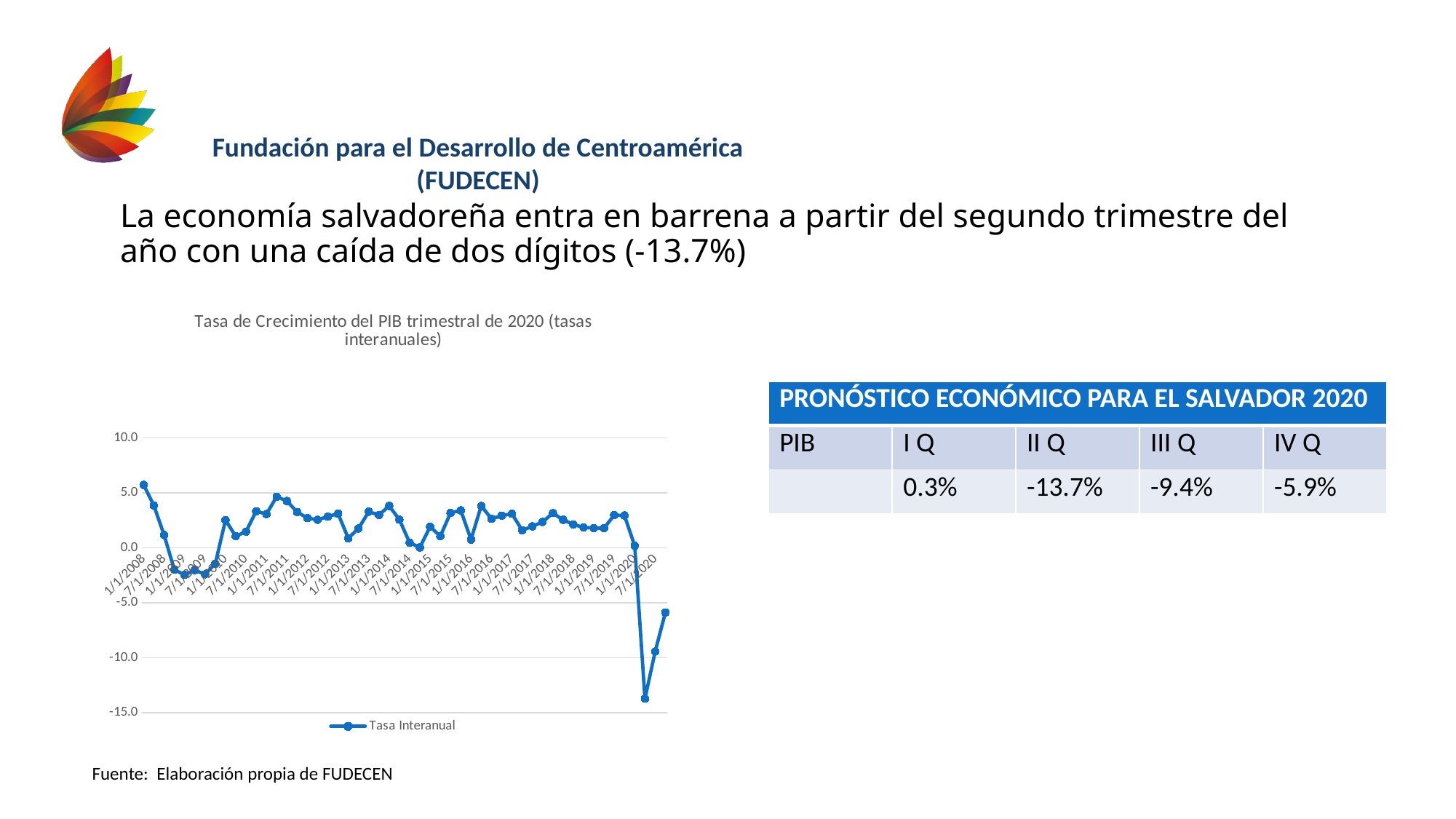
Which is larger, the value for 1/1/2008 or the value for 1/1/2020? 1/1/2008 Is the value for 7/1/2011 greater or less than 0.0? greater What is the name of the series shown in the chart legend? Tasa Interanual In which year does the lowest value on the chart occur? 2020 What kind of chart is shown on the slide? line chart Does the line rise or fall between 1/1/2008 and 7/1/2009? fall Is the lowest value on the chart greater or less than -10.0? less How many series does the chart legend list? 1 Is the value for 1/1/2015 greater or less than 5.0? less What is the title of the chart? Tasa de Crecimiento del PIB trimestral de 2020 (tasas interanuales)